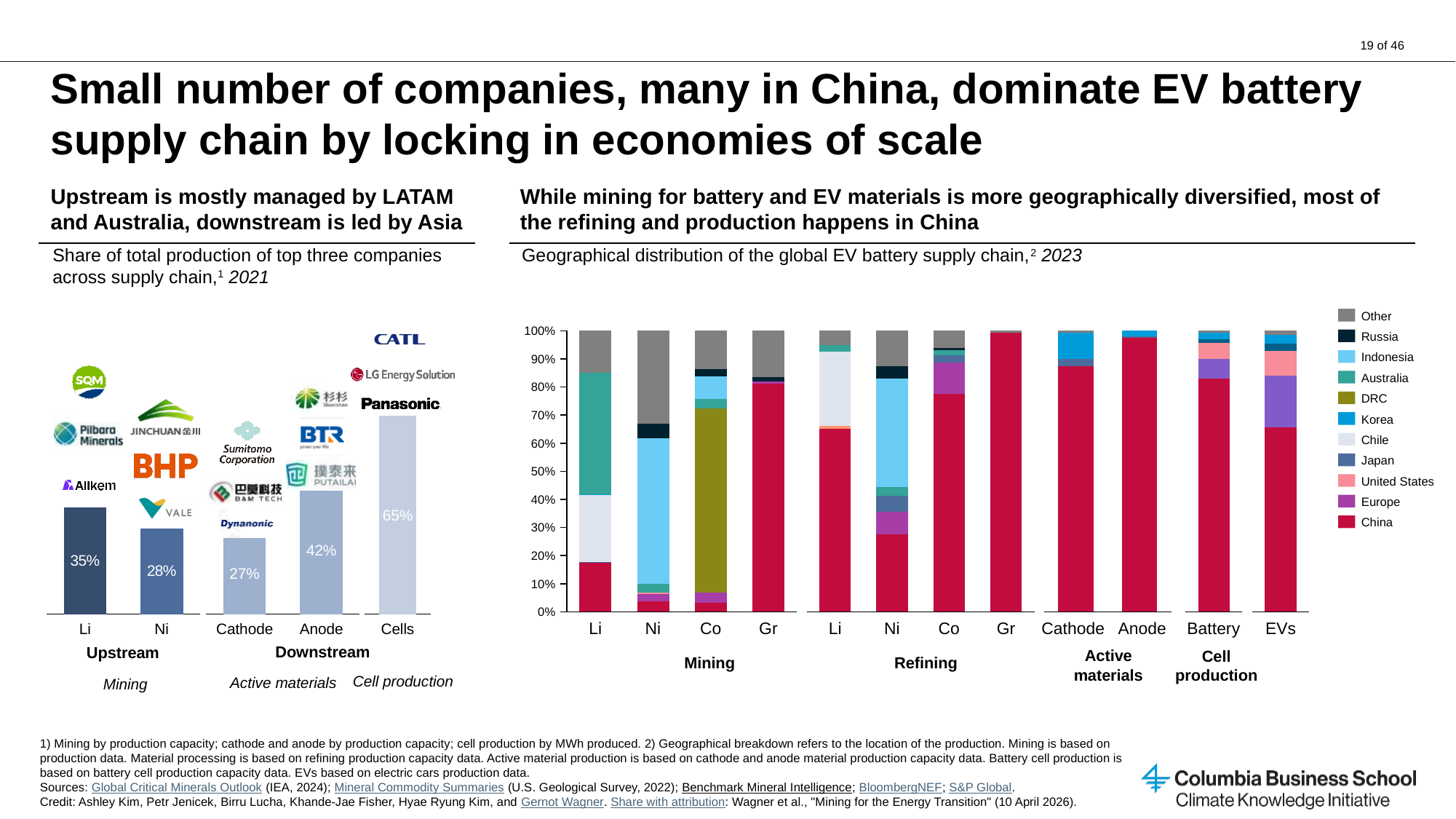
In the left chart (share of total production of top three companies), how many categories are plotted? 5 In the left chart (share of total production of top three companies), which is larger, the value for Li or the value for Anode? Anode In the right chart (geographical distribution of the global EV battery supply chain), how many series does the legend list? 11 In the left chart (share of total production of top three companies), what is the difference between the values for Cells and Li? 30% In the right chart (geographical distribution of the global EV battery supply chain), is the China share of the Gr bar under Mining greater or less than 70%? greater In the right chart (geographical distribution of the global EV battery supply chain), is the China share of the Ni bar under Mining greater or less than 10%? less In the left chart (share of total production of top three companies), what is the value for Cells? 65% In the left chart (share of total production of top three companies), which category has the lowest value? Cathode What kind of chart is the right chart (geographical distribution of the global EV battery supply chain)? Stacked bar chart In the left chart (share of total production of top three companies), what is the value for Anode? 42% In the left chart (share of total production of top three companies), what is the value for Ni? 28% In the left chart (share of total production of top three companies), which category has the highest value? Cells